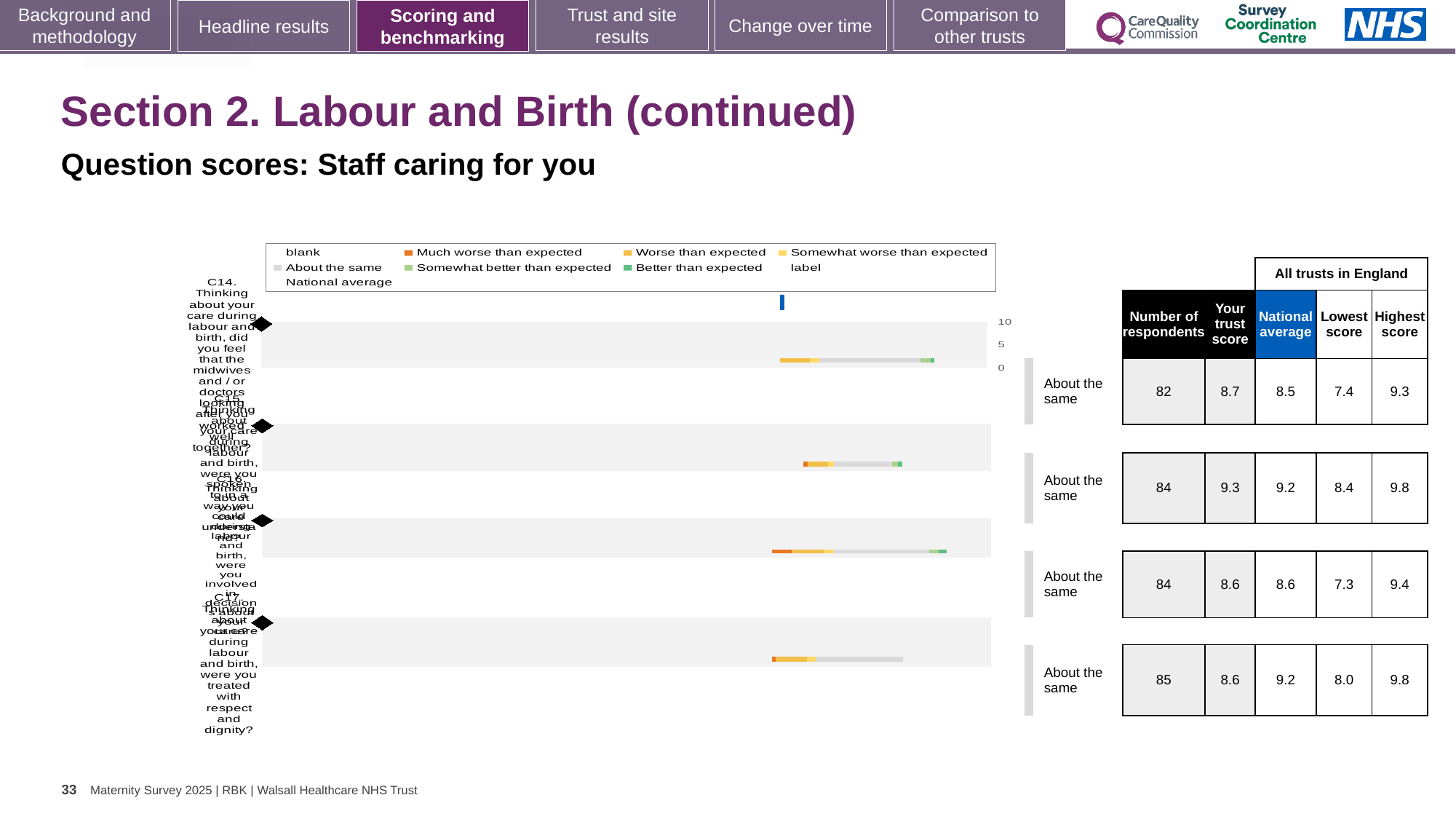
What is the difference between the trust score and the national average for the last row (C17)? 0.6 What is the number of respondents shown for the last row (C17)? 85 What kind of chart is shown on the slide? bar chart How many entries does the chart legend list? 9 What is the trust score shown for the first row (C14, midwives and/or doctors worked well together)? 8.7 What is the highest score across all trusts in England shown for the first row (C14)? 9.3 Which row has the highest trust score? the second row (C15) Which legend entry is shown in orange? Much worse than expected Is the trust score for the first row (C14) larger or smaller than its national average? larger How many question rows (categories) are plotted in the chart? 4 Which legend entry is shown in dark green? Better than expected What is the national average shown for the last row (C17, treated with respect and dignity)? 9.2